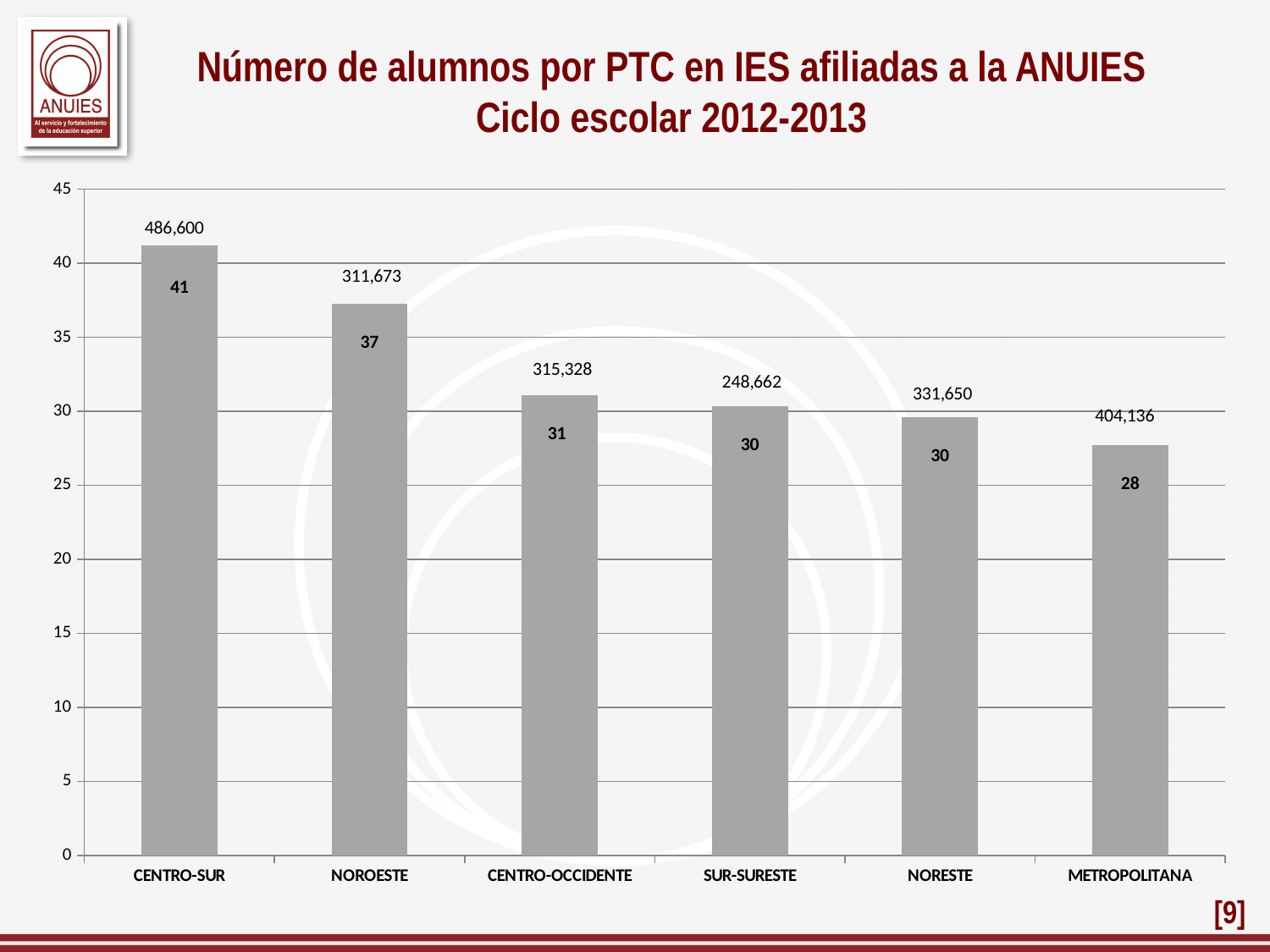
Do the bar values generally rise or fall from left to right across the x axis? fall What is the number of students per PTC shown inside the bar for METROPOLITANA? 28 Which region has the lowest number of students per PTC? METROPOLITANA What is the number of students per PTC shown inside the bar for CENTRO-SUR? 41 Which region has the highest number of students per PTC? CENTRO-SUR What is the number printed above the bar for SUR-SURESTE? 248,662 What type of chart is shown on the slide? bar chart What is the difference between the students per PTC for CENTRO-SUR and NOROESTE? 4 What is the number of students per PTC shown inside the bar for NOROESTE? 37 What is the number printed above the bar for NORESTE? 331,650 Which has a higher number of students per PTC, CENTRO-OCCIDENTE or METROPOLITANA? CENTRO-OCCIDENTE How many regions (categories) are shown on the x axis of the chart? 6